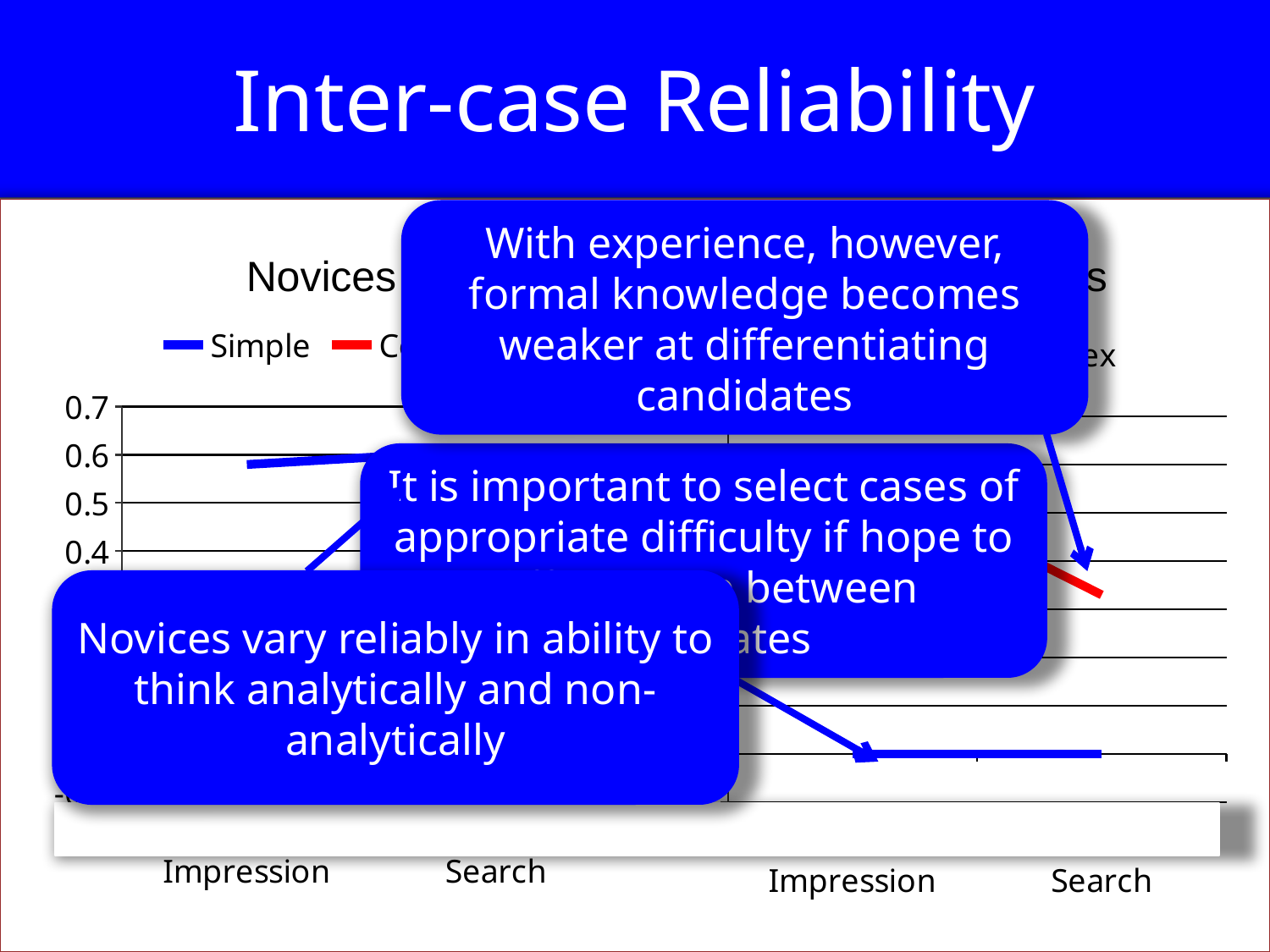
What are the two x-axis categories of the left chart? Impression and Search What kind of chart is the right chart on the slide? line chart What is the first word of the left chart's title? Novices In the left chart, is the value for Simple at Impression greater or less than 0.7? less How many categories are shown on the x axis of the left chart? 2 In the left chart, what colour is the line for the Simple series? blue In the left chart, is the value for Simple at Impression greater or less than 0.5? greater What kind of chart is the left chart on the slide? line chart How many categories are shown on the x axis of the right chart? 2 How many series does the legend of the left chart list? 2